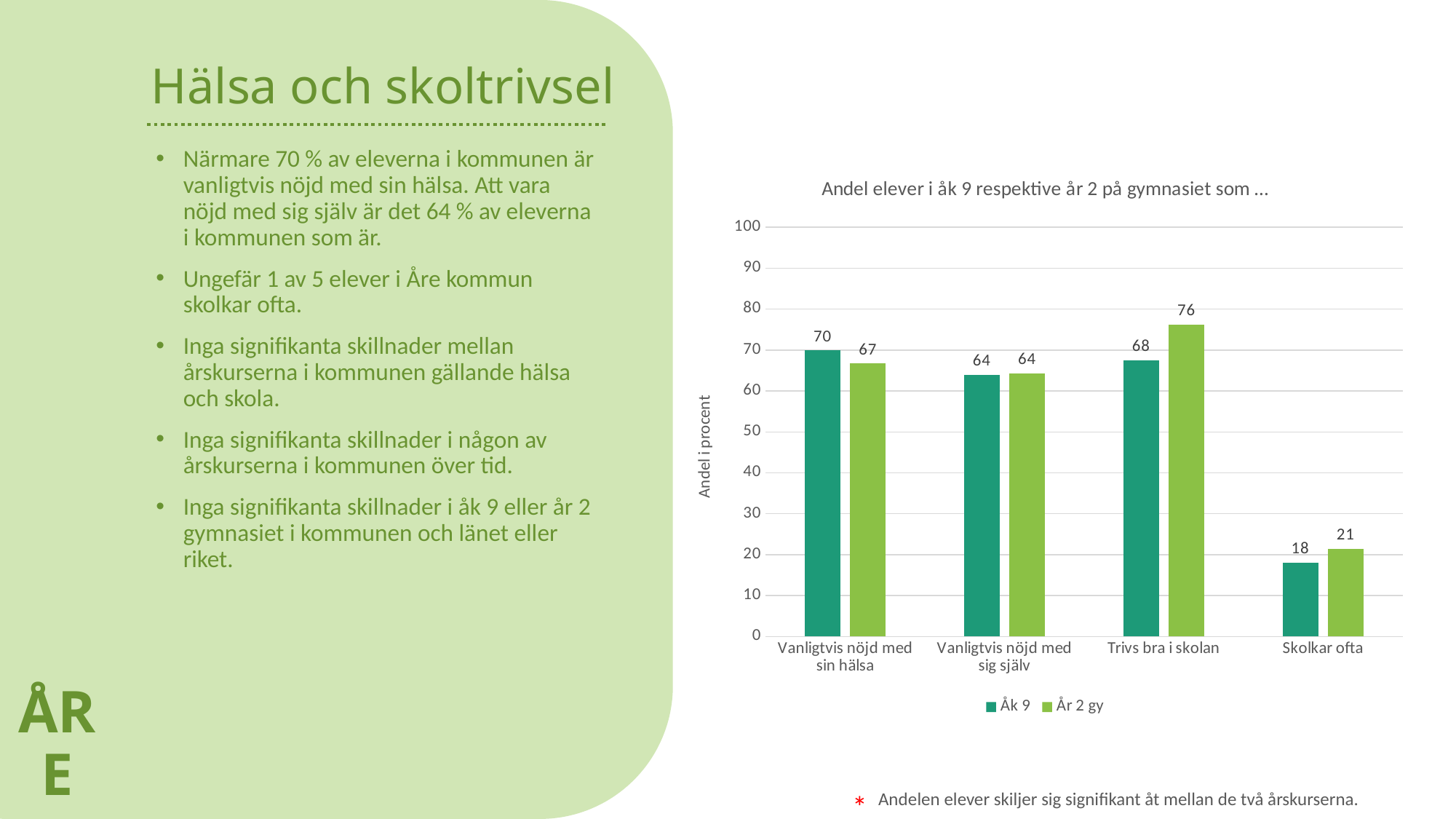
What is the value for Åk 9 in the category "Vanligtvis nöjd med sin hälsa"? 70 What kind of chart is shown on the slide? Bar chart Which category has the highest value for År 2 gy? Trivs bra i skolan How many categories are shown on the x axis? 4 Which is larger for "Vanligtvis nöjd med sin hälsa": the Åk 9 value or the År 2 gy value? Åk 9 What is the value for År 2 gy in the category "Trivs bra i skolan"? 76 How many series does the legend list? 2 What is the value for Åk 9 in the category "Skolkar ofta"? 18 What are the two series named in the legend? Åk 9 and År 2 gy What is the label of the y axis? Andel i procent What is the difference between the År 2 gy and Åk 9 values for "Trivs bra i skolan"? 8 Which category has the lowest value for Åk 9? Skolkar ofta